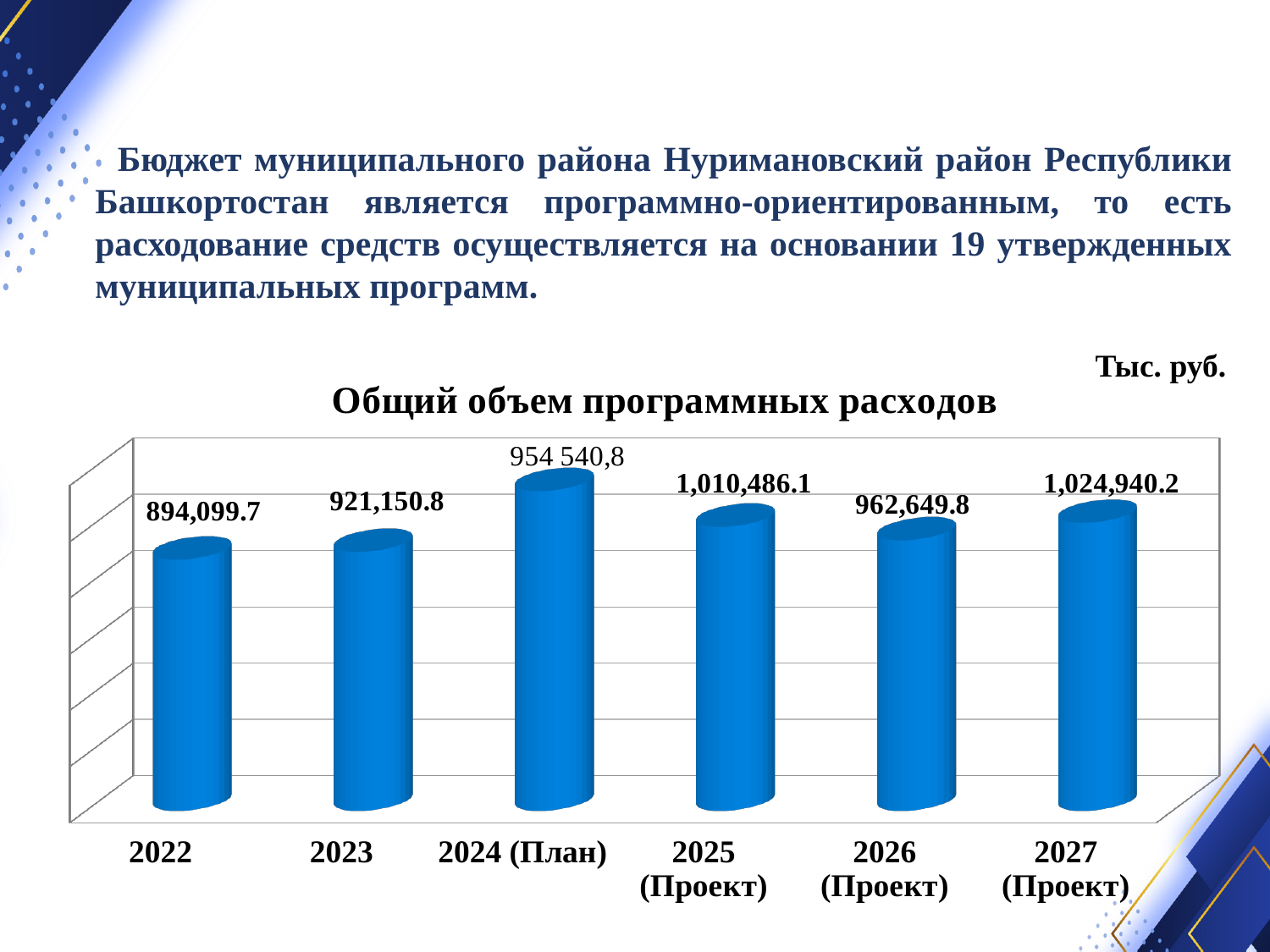
What kind of chart is shown on the slide? Bar chart What is the value for 2022 in the chart "Общий объем программных расходов"? 894,099.7 Which category has the lowest value in the chart? 2022 What unit of measurement is indicated above the chart? Тыс. руб. What is the value for 2025 (Проект)? 1,010,486.1 What is the value for 2023 in the chart? 921,150.8 Which category has the highest labelled value in the chart? 2027 (Проект) Which is larger, the value for 2025 (Проект) or for 2026 (Проект)? 2025 (Проект) What is the difference between the values for 2023 and 2022? 27,051.1 What is the value labelled for 2024 (План)? 954 540,8 How many categories are shown on the x axis of the chart? 6 What is the value for 2027 (Проект)? 1,024,940.2